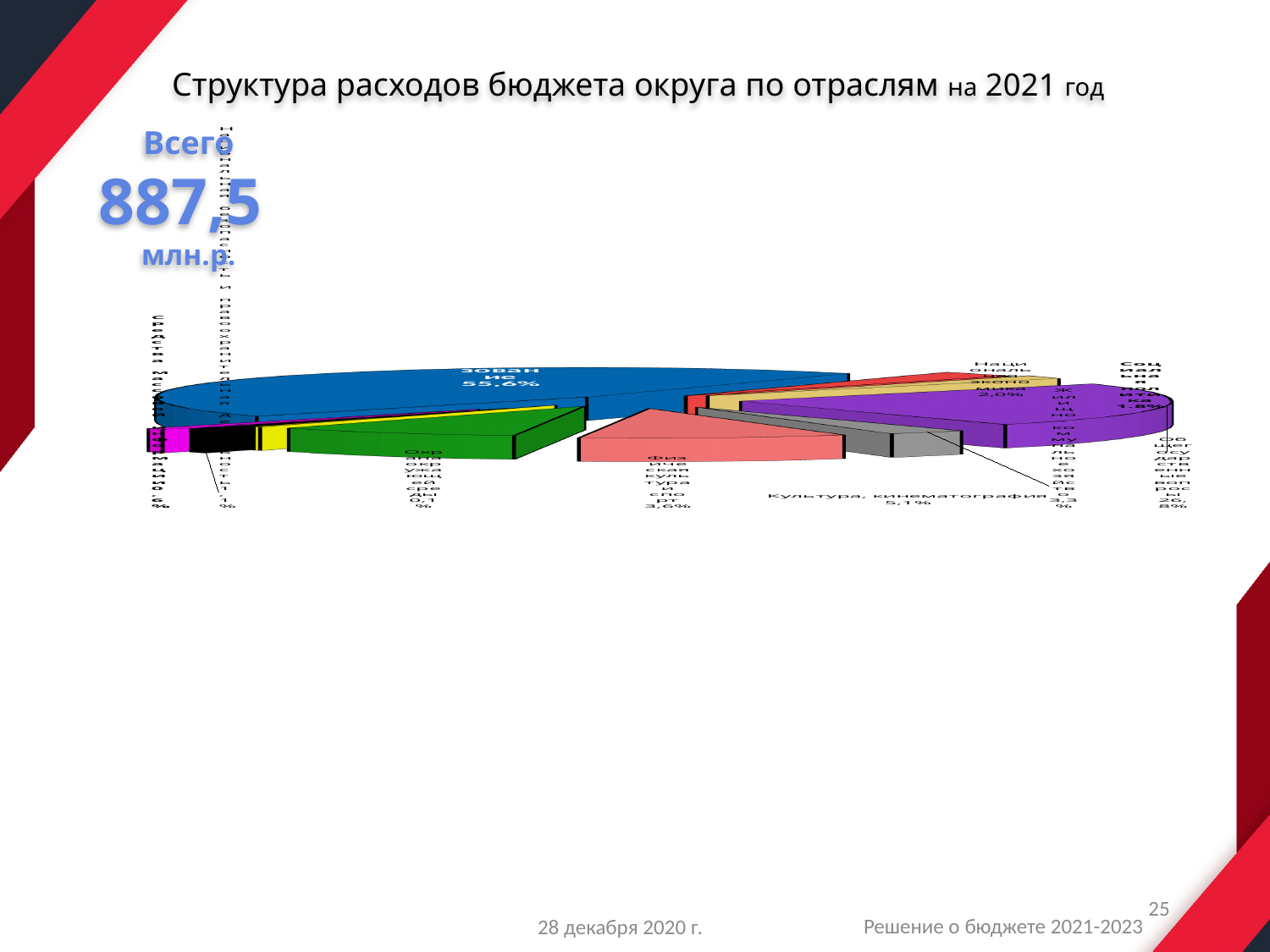
What share of the budget expenditure goes to Культура, кинематография? 5,1% What share of the budget expenditure goes to Охрана окружающей среды? 0,1% What total budget expenditure amount is shown on the slide? 887,5 млн.р. Which has a larger share: Культура, кинематография or Физическая культура и спорт? Культура, кинематография What kind of chart is shown on the slide? pie chart What is the title of the slide? Структура расходов бюджета округа по отраслям на 2021 год What share of the budget expenditure goes to Физическая культура и спорт? 3,6% What percentage is shown for the largest slice of the pie? 55,6% By how many percentage points does the share of Культура, кинематография exceed that of Физическая культура и спорт? 1,5 Which category has the smallest share of the budget expenditure? Охрана окружающей среды What share of the budget expenditure goes to Общегосударственные вопросы? 26,8% What share of the budget expenditure goes to Национальная экономика? 2,0%